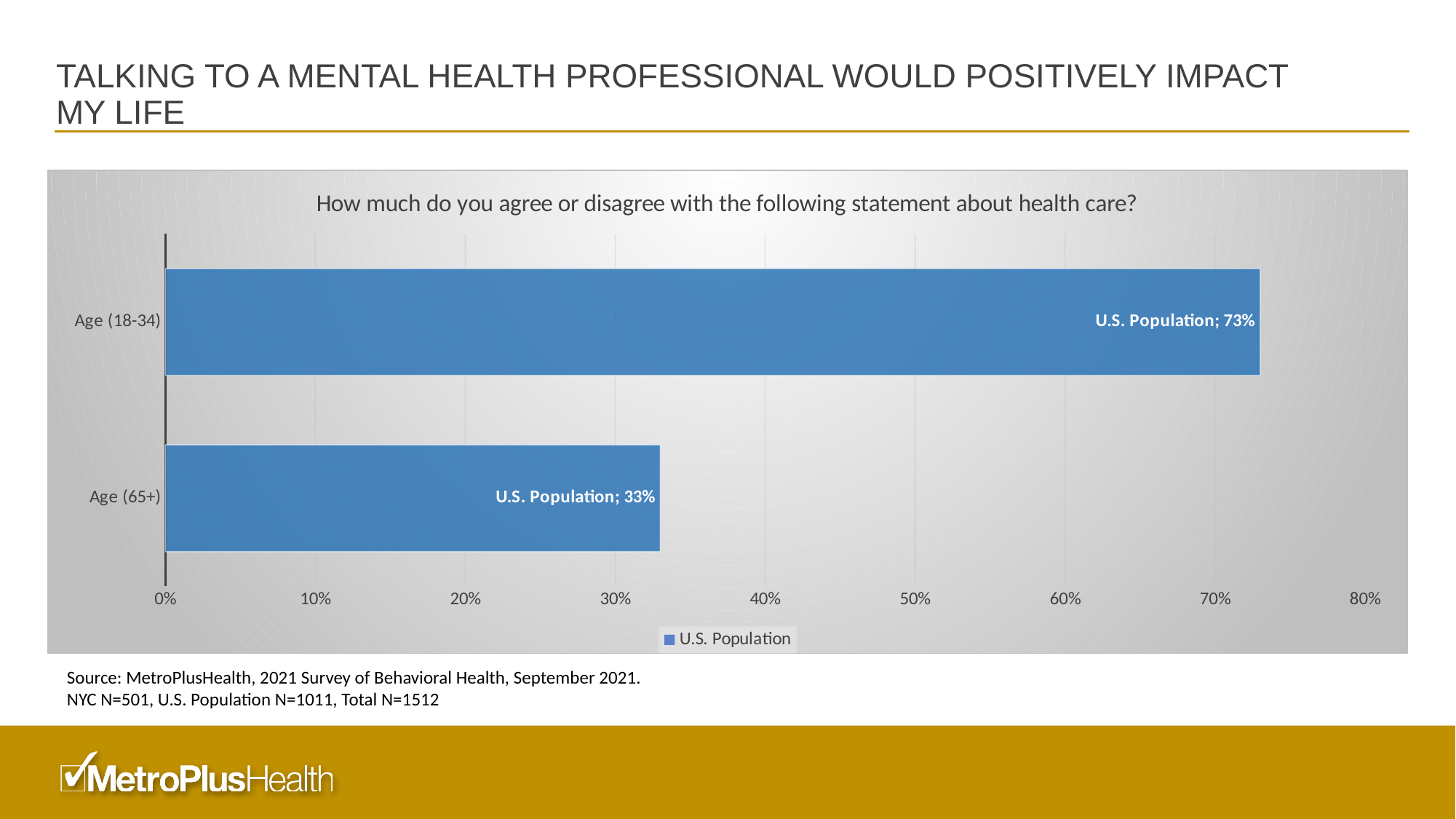
What kind of chart is shown on the slide? Bar chart What is the value for Age (65+)? 33% What is the difference between the values for Age (18-34) and Age (65+)? 40% What is the value for Age (18-34)? 73% How many age groups are shown in the chart? 2 Which age group has the lowest value? Age (65+) Which is larger, the value for Age (18-34) or the value for Age (65+)? Age (18-34) What series name does the legend show? U.S. Population Is the value for Age (65+) greater or less than 40%? less How many series does the legend list? 1 Is the value for Age (18-34) greater or less than 70%? greater Which age group has the highest value? Age (18-34)